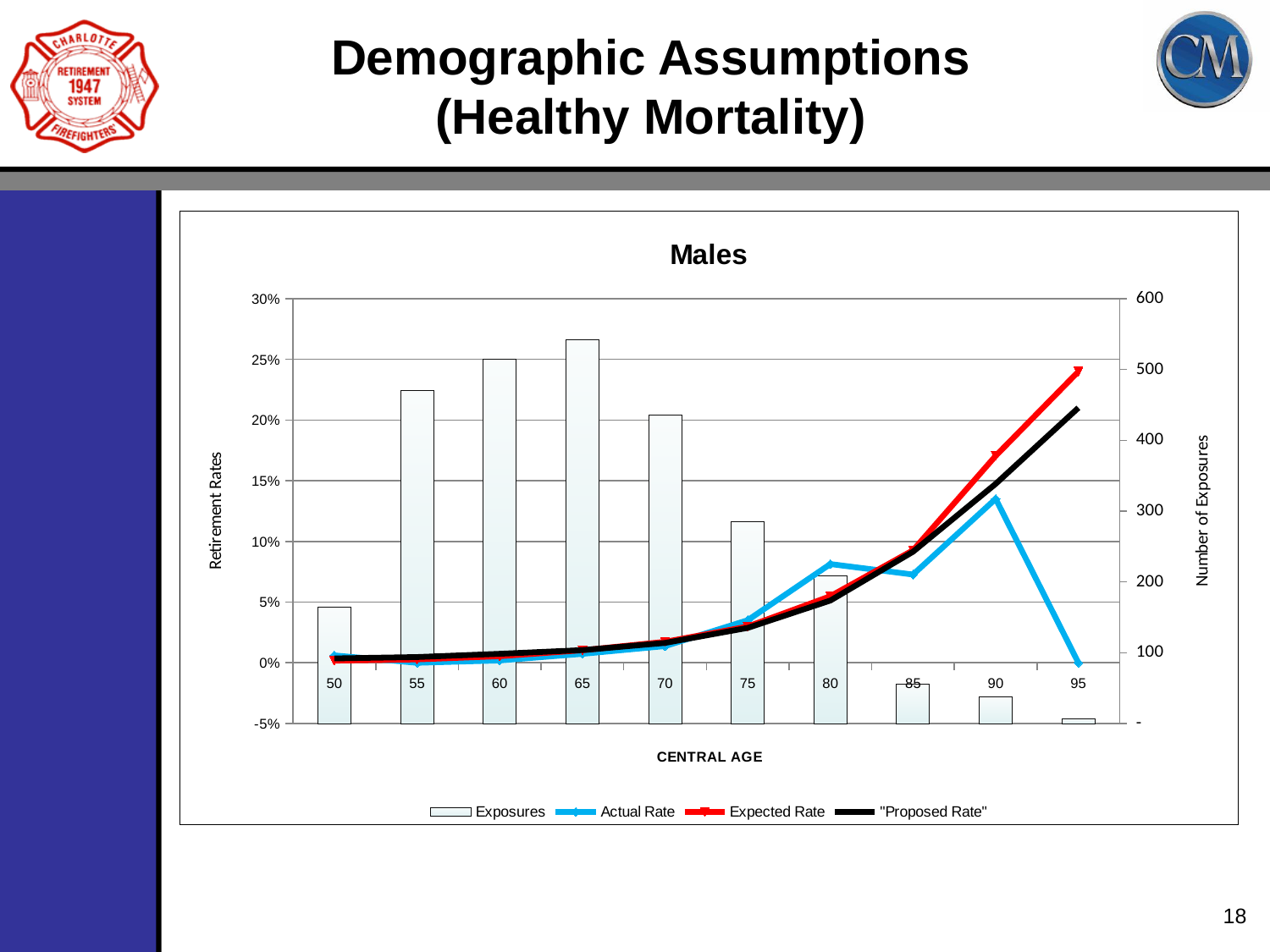
How many central age categories are shown on the x axis? 10 What is the title of the chart? Males What kind of chart is shown on the slide? Combination bar and line chart Is the Actual Rate at central age 90 greater or less than 10%? greater Which central age has the highest number of Exposures? 65 Is the number of Exposures at central age 65 greater or less than 500? greater Is the Expected Rate at central age 95 greater or less than 20%? greater How many series does the legend list? 4 Which central age has the lowest number of Exposures? 95 At central age 95, which is higher, the Expected Rate or the "Proposed Rate"? Expected Rate Does the Expected Rate rise or fall as central age increases from 50 to 95? rise